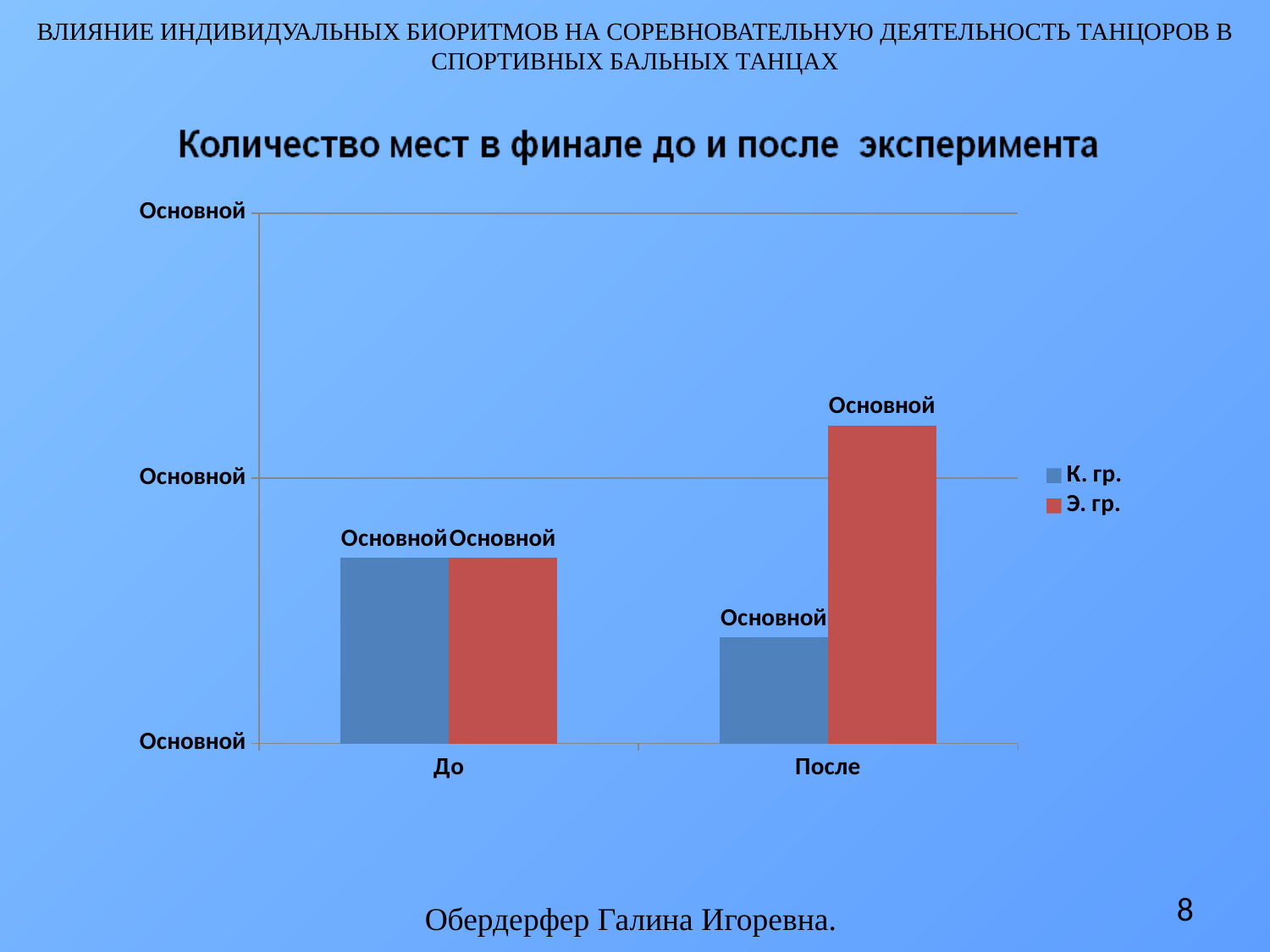
For the К. гр. series, which category has the higher value, До or После? До What are the two series named in the legend? К. гр. and Э. гр. What kind of chart is shown on the slide? bar chart For the Э. гр. series, is the value in После larger or smaller than in До? larger Which bar is the tallest in the chart? Э. гр. in После Which bar is the shortest in the chart? К. гр. in После In the После category, which series has the larger value, К. гр. or Э. гр.? Э. гр. Does the Э. гр. series rise or fall from До to После? rise What is the title of the chart? Количество мест в финале до и после эксперимента Does the К. гр. series rise or fall from До to После? fall How many series does the legend list? 2 How many categories are shown on the x axis? 2